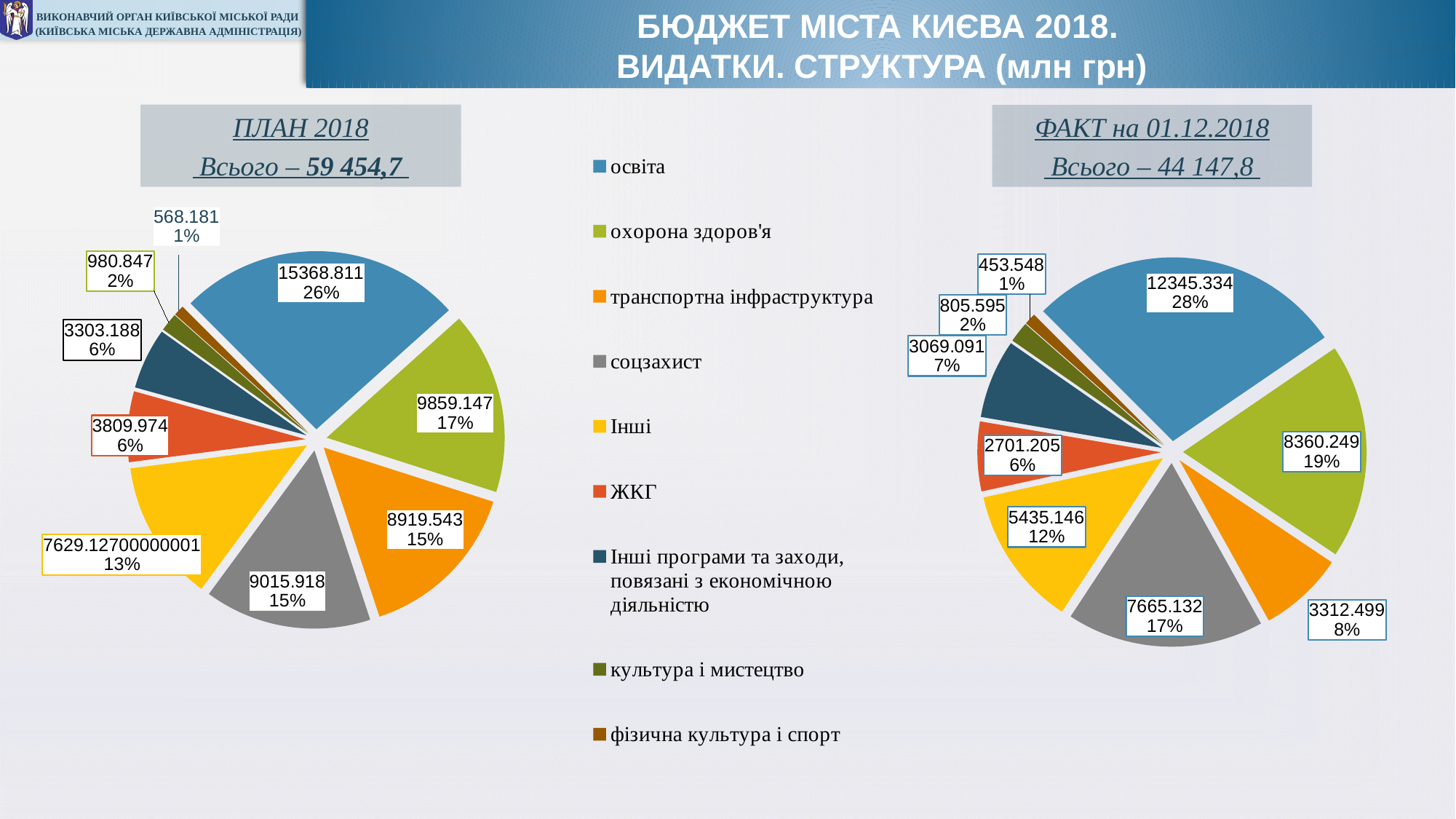
In the ФАКТ на 01.12.2018 pie chart, what is the value for соцзахист? 7665.132 How many categories does the legend list? 9 In the ФАКТ на 01.12.2018 pie chart, what share does освіта have? 28% In the ПЛАН 2018 pie chart, which category has the smallest slice? фізична культура і спорт In the ФАКТ на 01.12.2018 pie chart, which is larger: the value for ЖКГ or the value for Інші програми та заходи, повязані з економічною діяльністю? Інші програми та заходи, повязані з економічною діяльністю In the ПЛАН 2018 pie chart, what is the difference between the values for охорона здоров'я and соцзахист? 843.229 In the ПЛАН 2018 pie chart, what is the value for освіта? 15368.811 In the ФАКТ на 01.12.2018 pie chart, what is the value for транспортна інфраструктура? 3312.499 In the ФАКТ на 01.12.2018 pie chart, which category has the largest slice? освіта What type of chart is used on the slide for ПЛАН 2018 and ФАКТ на 01.12.2018? pie chart What total is shown for ФАКТ на 01.12.2018? 44 147,8 In the ПЛАН 2018 pie chart, what share does Інші have? 13%